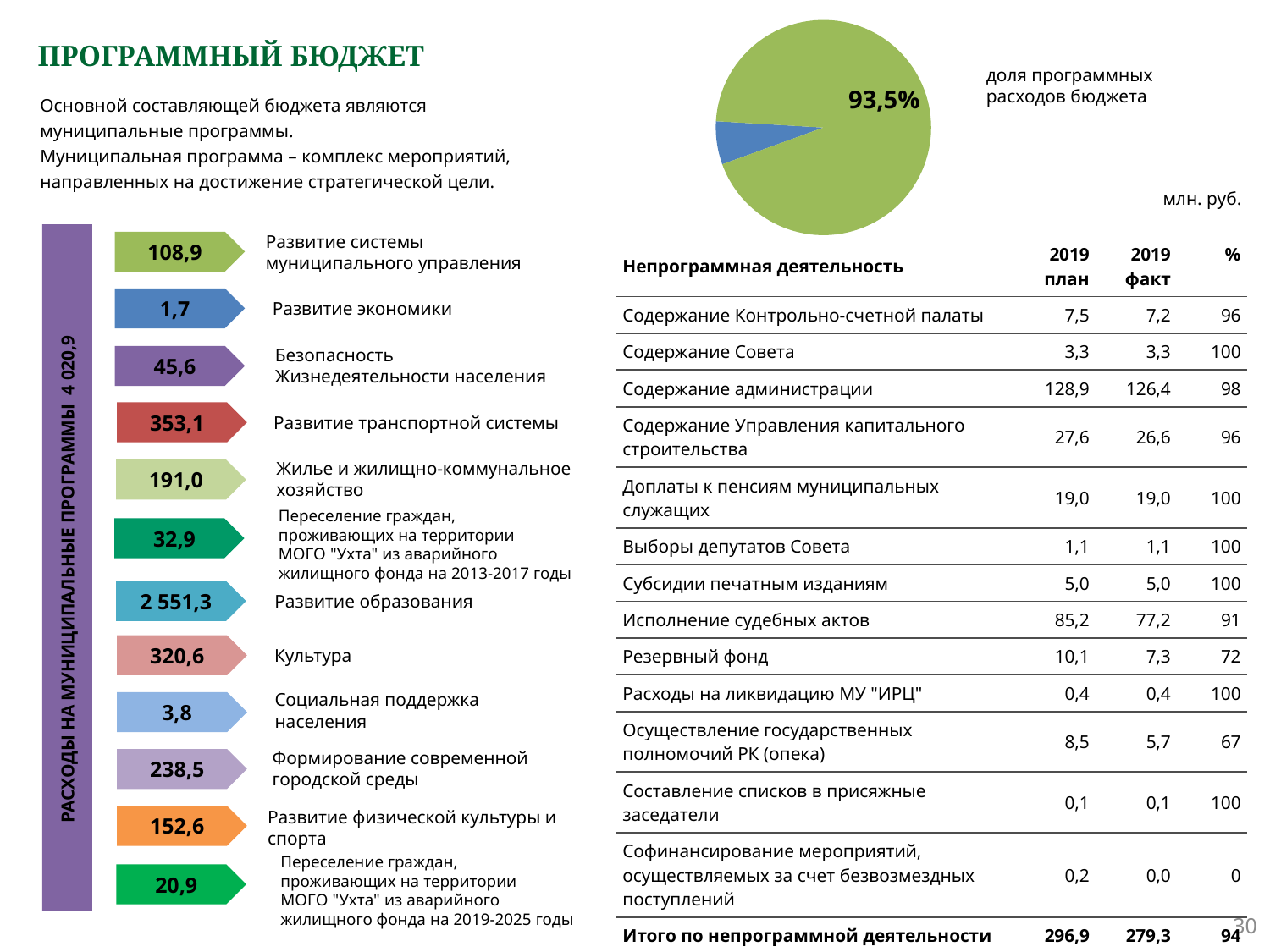
In the pie chart, which slice is larger, the green one or the blue one? the green one In the arrow diagram on the left, what is the value for Развитие образования? 2 551,3 In the arrow diagram on the left, which programme has the highest value? Развитие образования In the arrow diagram on the left, which programme has the lowest value? Развитие экономики In the pie chart, what share is labelled on the large green slice? 93,5% In the arrow diagram on the left, what is the difference between Развитие транспортной системы (353,1) and Культура (320,6)? 32,5 In the arrow diagram on the left, what is the value for Культура? 320,6 In the pie chart, is the share of the blue slice greater or less than 50%? less In the arrow diagram on the left, how many programmes are listed? 12 How many slices does the pie chart have? 2 What type of chart is shown at the top right of the slide? pie chart What does the pie chart represent, according to the caption next to it? доля программных расходов бюджета